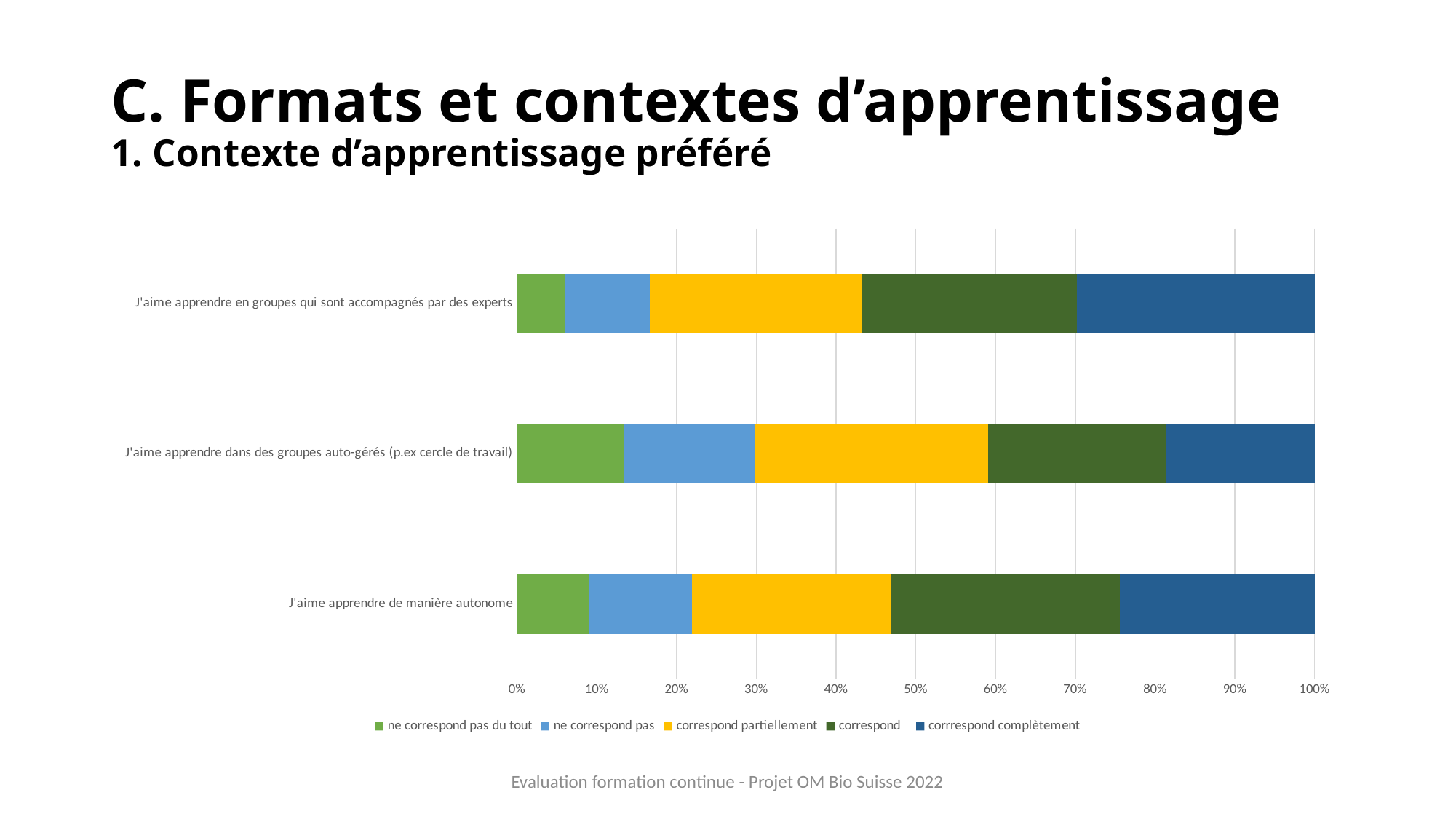
Which statement has the largest "corrrespond complètement" share? J'aime apprendre en groupes qui sont accompagnés par des experts Is the "ne correspond pas du tout" share larger for "J'aime apprendre dans des groupes auto-gérés (p.ex cercle de travail)" or for "J'aime apprendre en groupes qui sont accompagnés par des experts"? J'aime apprendre dans des groupes auto-gérés (p.ex cercle de travail) Is the "correspond partiellement" share for "J'aime apprendre dans des groupes auto-gérés (p.ex cercle de travail)" greater or less than 20%? greater How many series does the legend list? 5 What is the highest value shown on the horizontal axis? 100% How many categories (statements) are plotted on the chart? 3 Which statement has the largest "ne correspond pas" share? J'aime apprendre dans des groupes auto-gérés (p.ex cercle de travail) What kind of chart is shown on the slide? bar chart Which statement has the smallest "ne correspond pas du tout" share? J'aime apprendre en groupes qui sont accompagnés par des experts Is the "corrrespond complètement" share for "J'aime apprendre en groupes qui sont accompagnés par des experts" greater or less than 20%? greater Which colour represents "correspond partiellement" in the chart? yellow Is the "ne correspond pas du tout" share for "J'aime apprendre en groupes qui sont accompagnés par des experts" greater or less than 10%? less